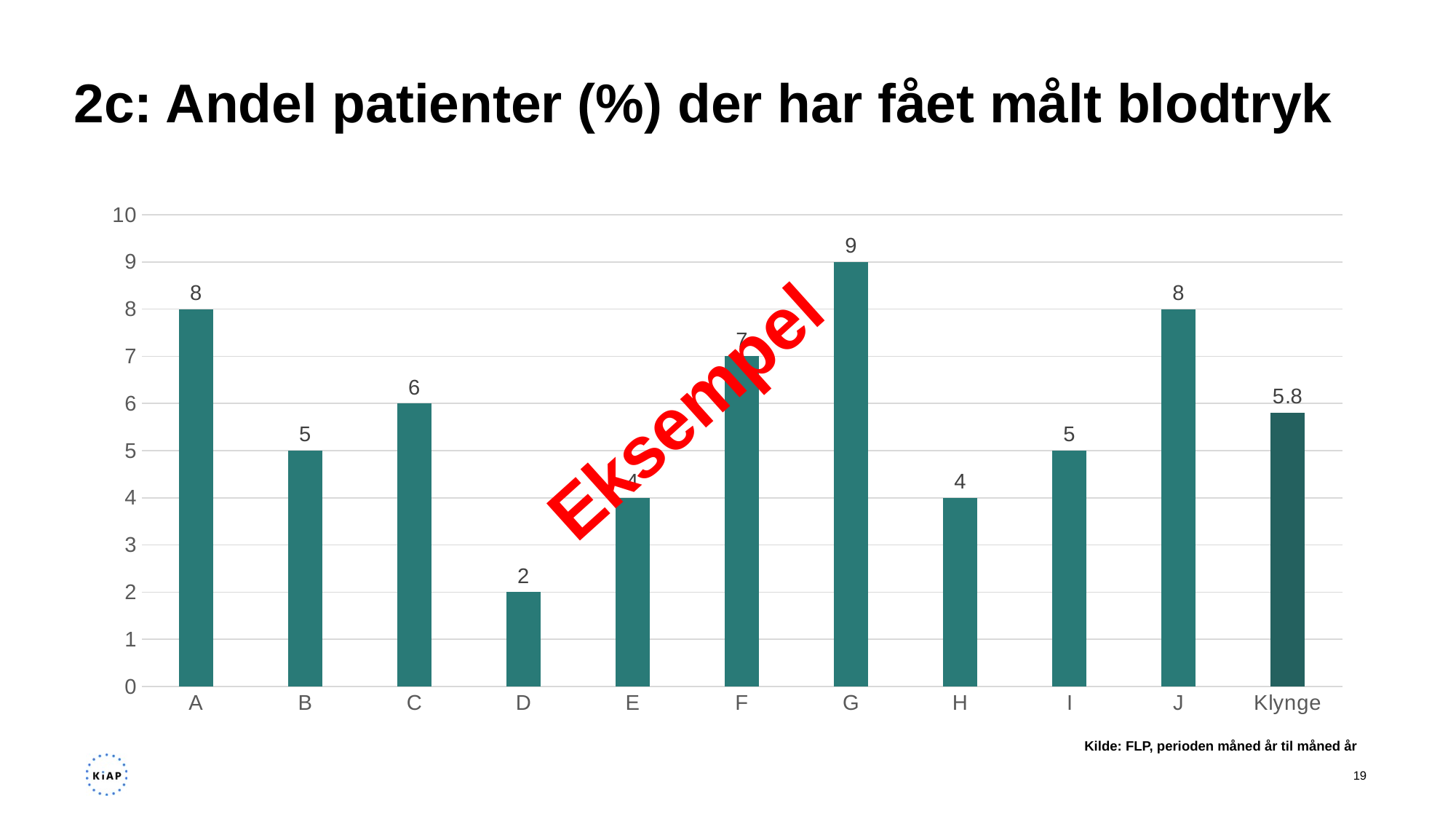
What is the difference between the values for G and D? 7 What is the value for Klynge? 5.8 What is the difference between the values for A and B? 3 What is the value for category D? 2 What is the value for category G? 9 Which category has the lowest value? D How many categories are shown on the x axis? 11 What is the title of the slide? 2c: Andel patienter (%) der har fået målt blodtryk What kind of chart is shown on the slide? bar chart Which category has the highest value? G Which is larger, the value for C or the value for H? C Is the value for J greater or less than 5? greater